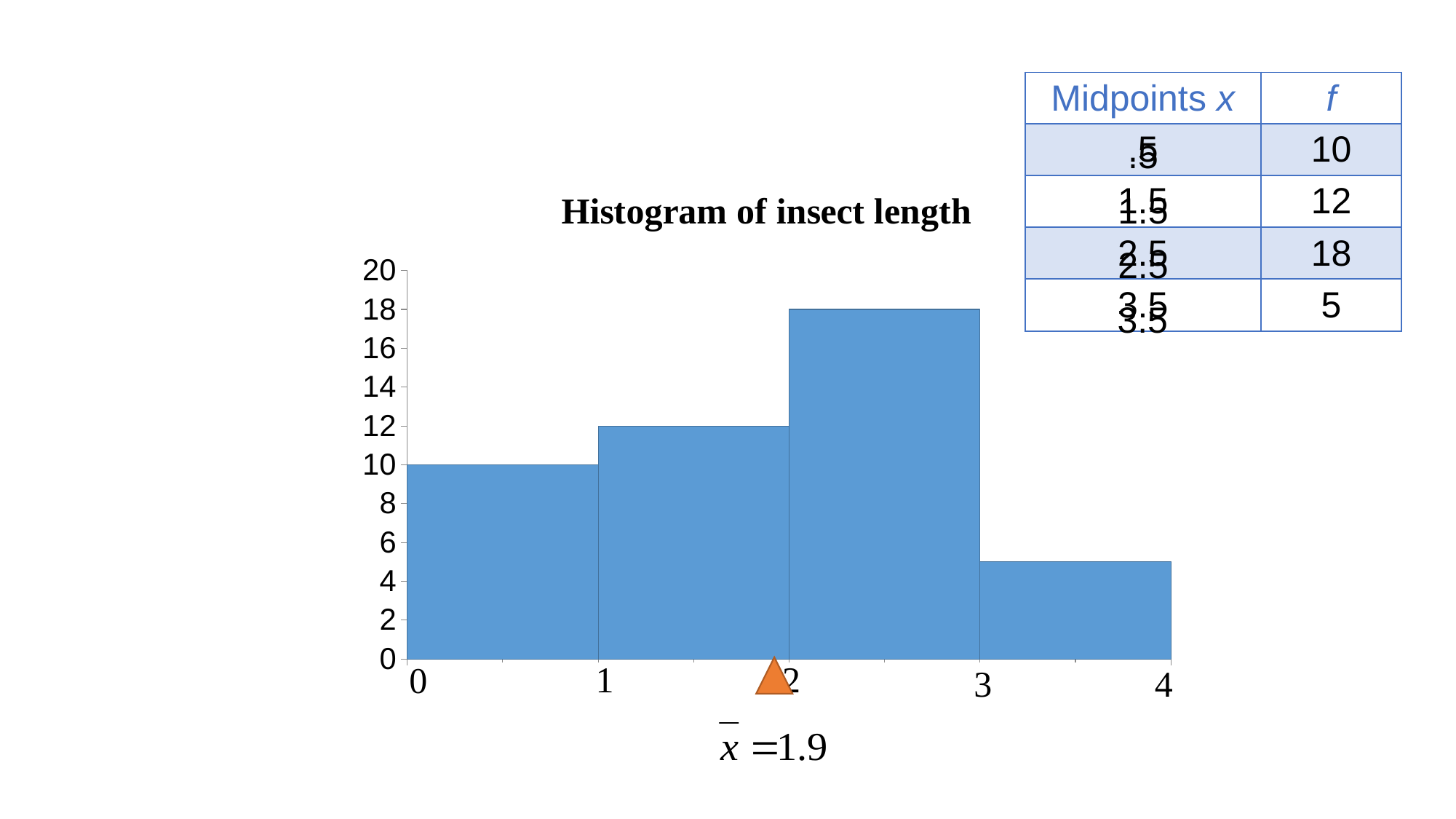
What value of the mean is marked below the x axis? 1.9 Which has a larger frequency, the 0 to 1 interval or the 1 to 2 interval? 1 to 2 What is the frequency for the interval from 1 to 2? 12 Which interval has the highest frequency? 2 to 3 What is the frequency for the interval from 0 to 1? 10 What kind of chart is shown on the slide? bar chart (histogram) Which interval has the lowest frequency? 3 to 4 How many bars does the histogram have? 4 What is the title of the chart? Histogram of insect length What is the frequency for the interval from 3 to 4? 5 What is the frequency for the interval from 2 to 3? 18 What is the difference between the frequency of the 2 to 3 interval and the 1 to 2 interval? 6